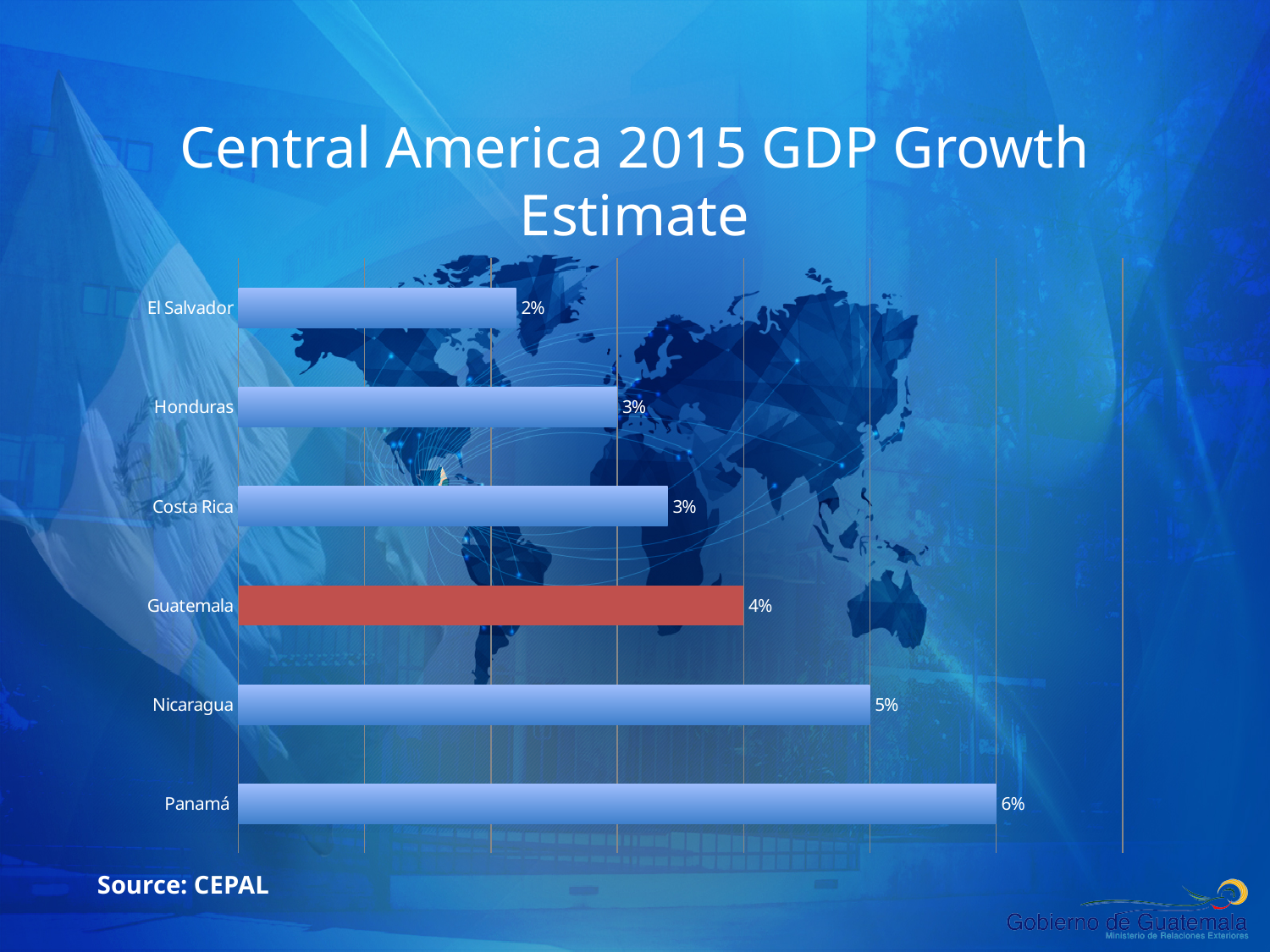
What is the difference between the GDP growth estimates for Panamá and El Salvador? 4% What is the 2015 GDP growth estimate shown for El Salvador? 2% How many countries are shown on the chart? 6 Which country has the highest GDP growth estimate on the chart? Panamá Which has a higher GDP growth estimate, Nicaragua or Guatemala? Nicaragua What is the 2015 GDP growth estimate shown for Nicaragua? 5% Which country has the lowest GDP growth estimate on the chart? El Salvador What is the 2015 GDP growth estimate shown for Guatemala? 4% What kind of chart is shown on the slide? Bar chart Which country's bar is shown in a different colour (red) from the others? Guatemala What is the 2015 GDP growth estimate shown for Panamá? 6% Do the GDP growth estimates increase or decrease going from El Salvador at the top to Panamá at the bottom? Increase